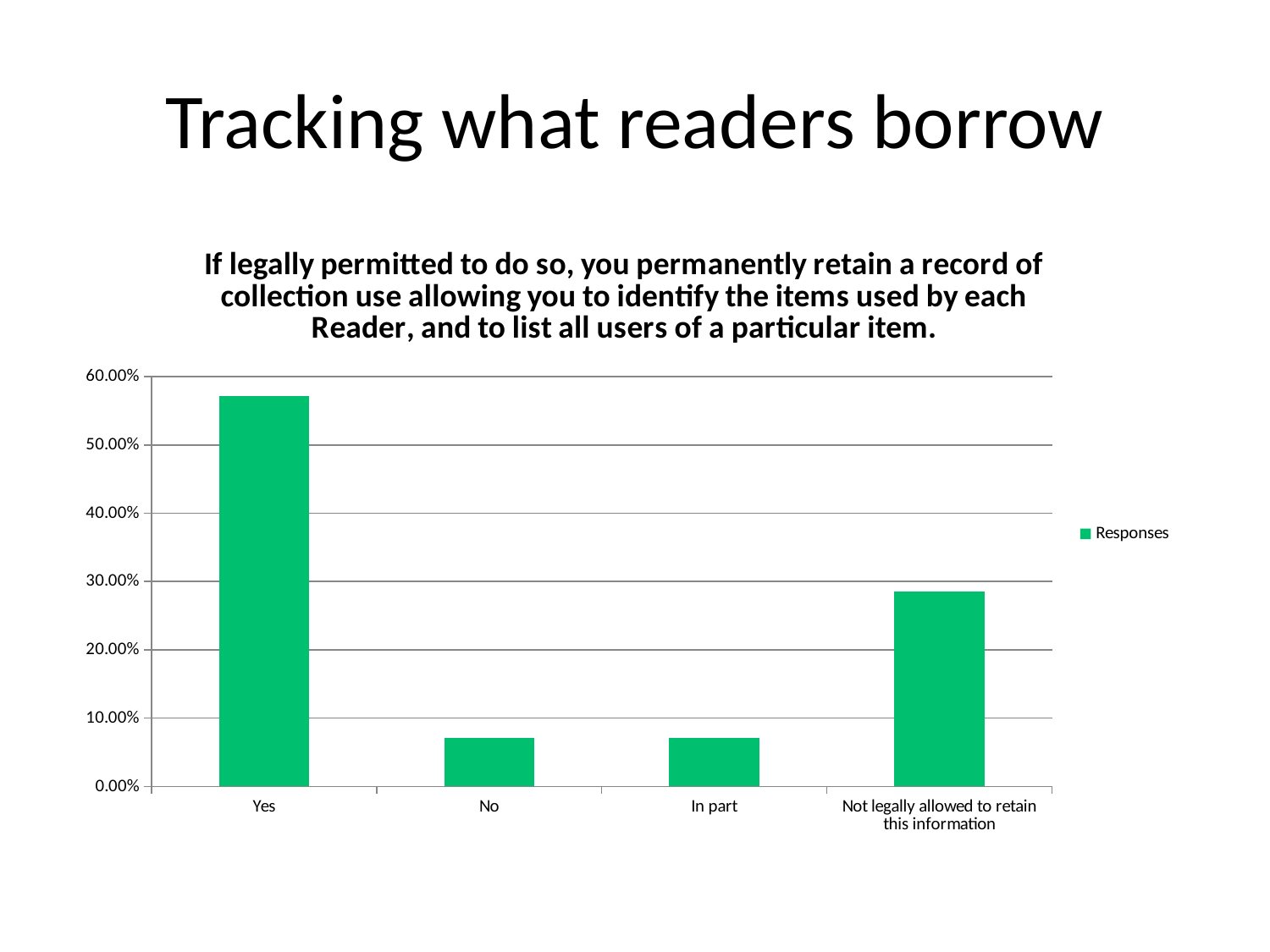
Is the value for No greater or less than 10.00%? less What is the name of the series listed in the chart legend? Responses Which is larger, the value for Yes or the value for 'Not legally allowed to retain this information'? Yes Is the value for 'Not legally allowed to retain this information' greater or less than 20.00%? greater Is the value for 'Not legally allowed to retain this information' greater or less than 30.00%? less What kind of chart is shown on the slide? bar chart How many categories are shown on the x axis of the chart? 4 Which is larger, the value for No or the value for 'Not legally allowed to retain this information'? Not legally allowed to retain this information How many series does the chart legend list? 1 Which category has the highest value in the chart? Yes